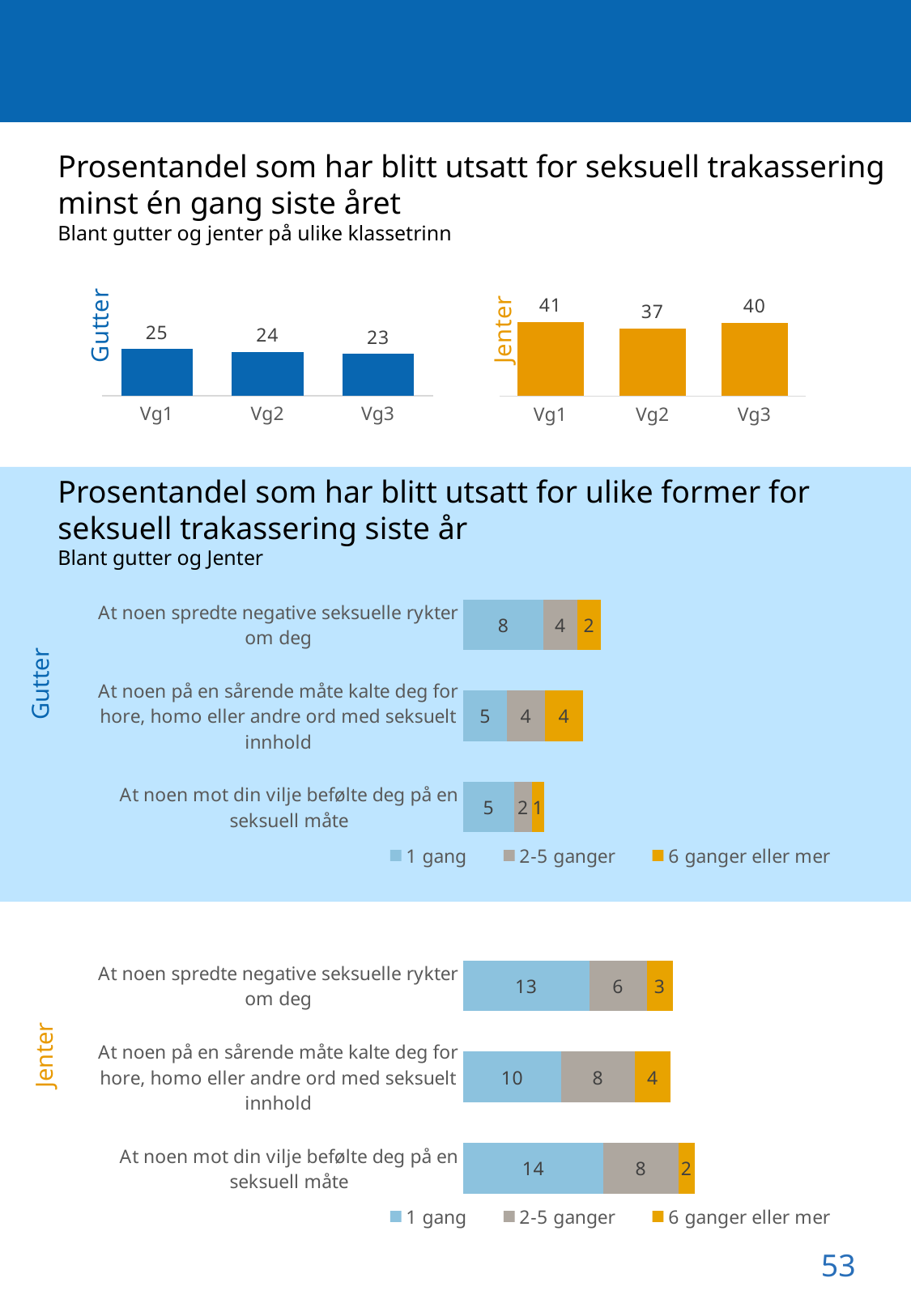
In the stacked 'Gutter' chart in the middle, what is the '6 ganger eller mer' value for 'At noen på en sårende måte kalte deg for hore, homo eller andre ord med seksuelt innhold'? 4 In the top 'Jenter' bar chart, what is the value for Vg2? 37 How many series does the legend list in the stacked 'Gutter' chart in the middle of the slide? 3 In the stacked 'Jenter' chart at the bottom, what is the total of the bar for 'At noen spredte negative seksuelle rykter om deg'? 22 In the top 'Gutter' bar chart, what is the value for Vg1? 25 In the stacked 'Gutter' chart in the middle, what is the total of the bar for 'At noen mot din vilje befølte deg på en seksuell måte'? 8 In the top 'Gutter' bar chart, which class level has the lowest value? Vg3 In the top 'Gutter' bar chart, do the values rise or fall from Vg1 to Vg3? fall In the stacked 'Jenter' chart at the bottom, what is the '1 gang' value for 'At noen mot din vilje befølte deg på en seksuell måte'? 14 What type of chart is the top 'Jenter' chart? bar chart In the top 'Jenter' bar chart, which class level has the highest value? Vg1 What is the difference between the Vg1 value in the top 'Jenter' chart and the Vg1 value in the top 'Gutter' chart? 16